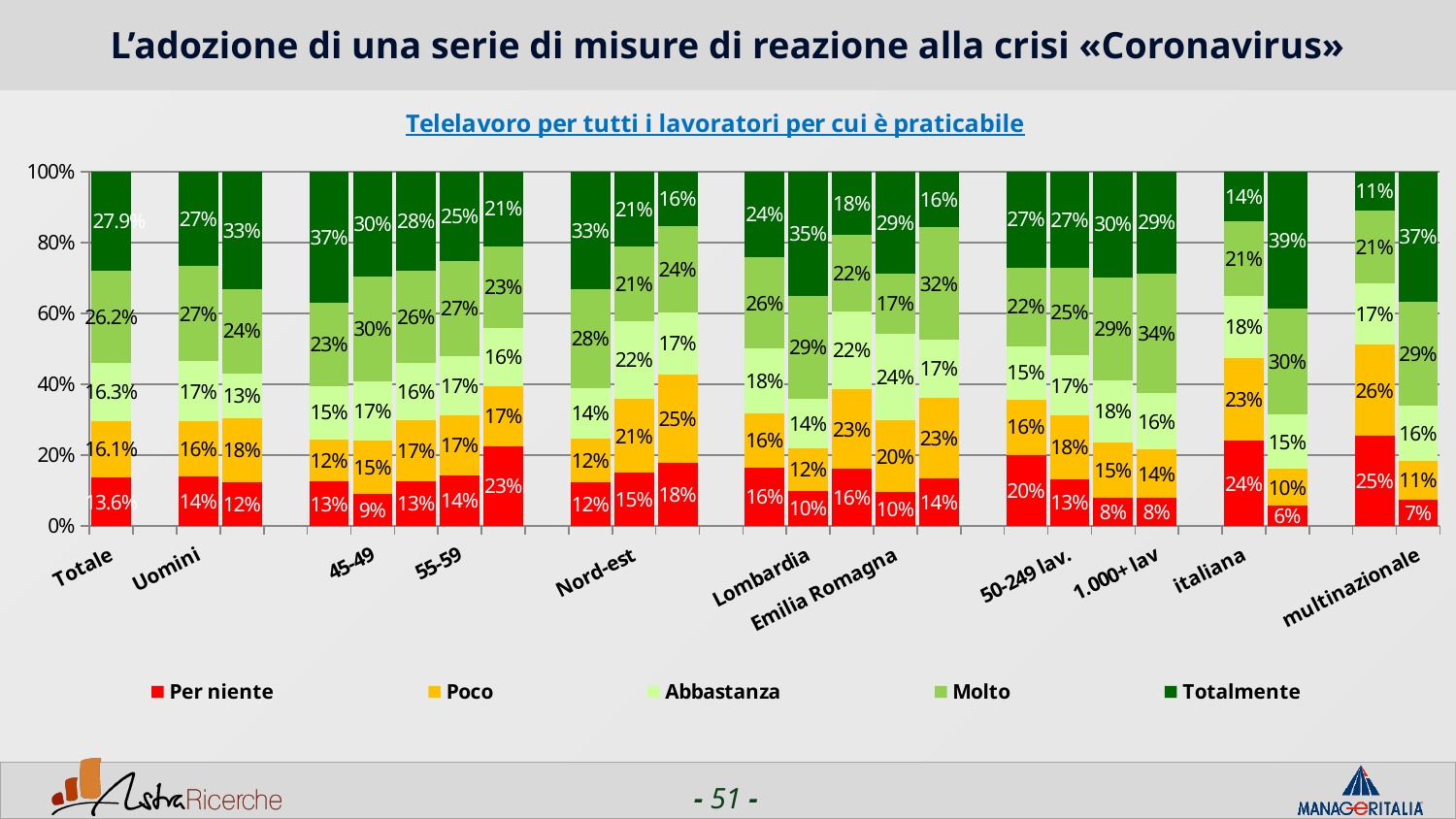
What is the 'Totalmente' value for multinazionale? 37% Which is larger, the 'Per niente' value for 45-49 or for 55-59? 55-59 What is the 'Molto' value for 1.000+ lav? 34% What is the difference between the 'Per niente' values for italiana and multinazionale? 17% What is the 'Poco' value for Emilia Romagna? 20% What is the 'Totalmente' value for Lombardia? 35% What type of chart is shown on the slide? Stacked bar chart How many series does the legend list? 5 What is the 'Abbastanza' value for Nord-est? 22% Which is larger, the 'Totalmente' value for Lombardia or for Emilia Romagna? Lombardia What is the 'Per niente' value for Totale? 13.6% What is the title of the chart? Telelavoro per tutti i lavoratori per cui è praticabile